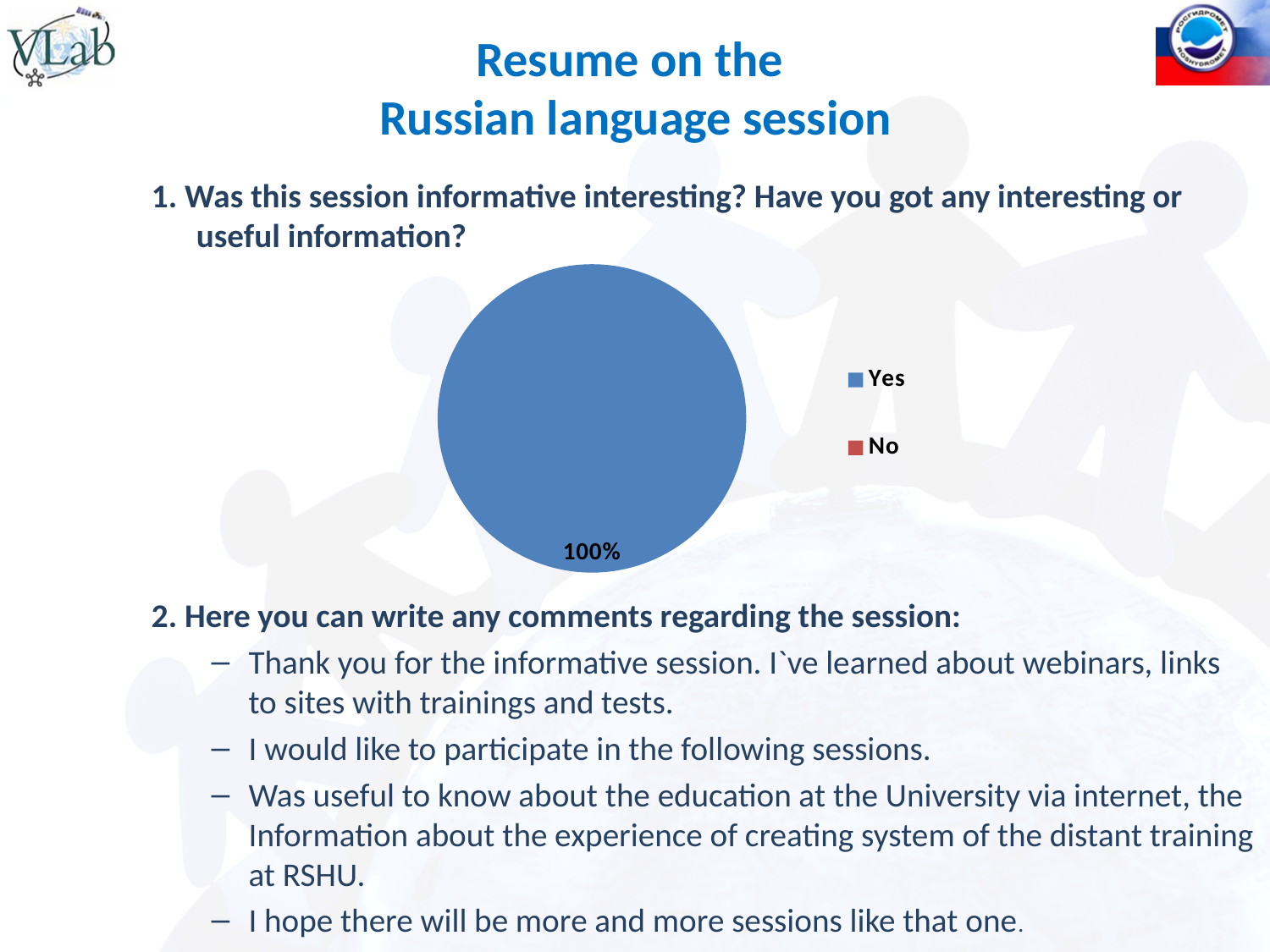
What percentage is shown for the Yes slice of the pie chart? 100% Which of the two categories, Yes or No, has the larger share of the pie? Yes What kind of chart is shown on the slide? pie chart What are the two legend entries of the pie chart? Yes and No How many data labels are printed on the pie chart? 1 Is the share for Yes greater or less than 50%? greater What colour represents the Yes category in the pie chart? blue Which category has the largest share of the pie chart? Yes What share of the pie does the Yes category take? 100% How many entries does the legend of the pie chart list? 2